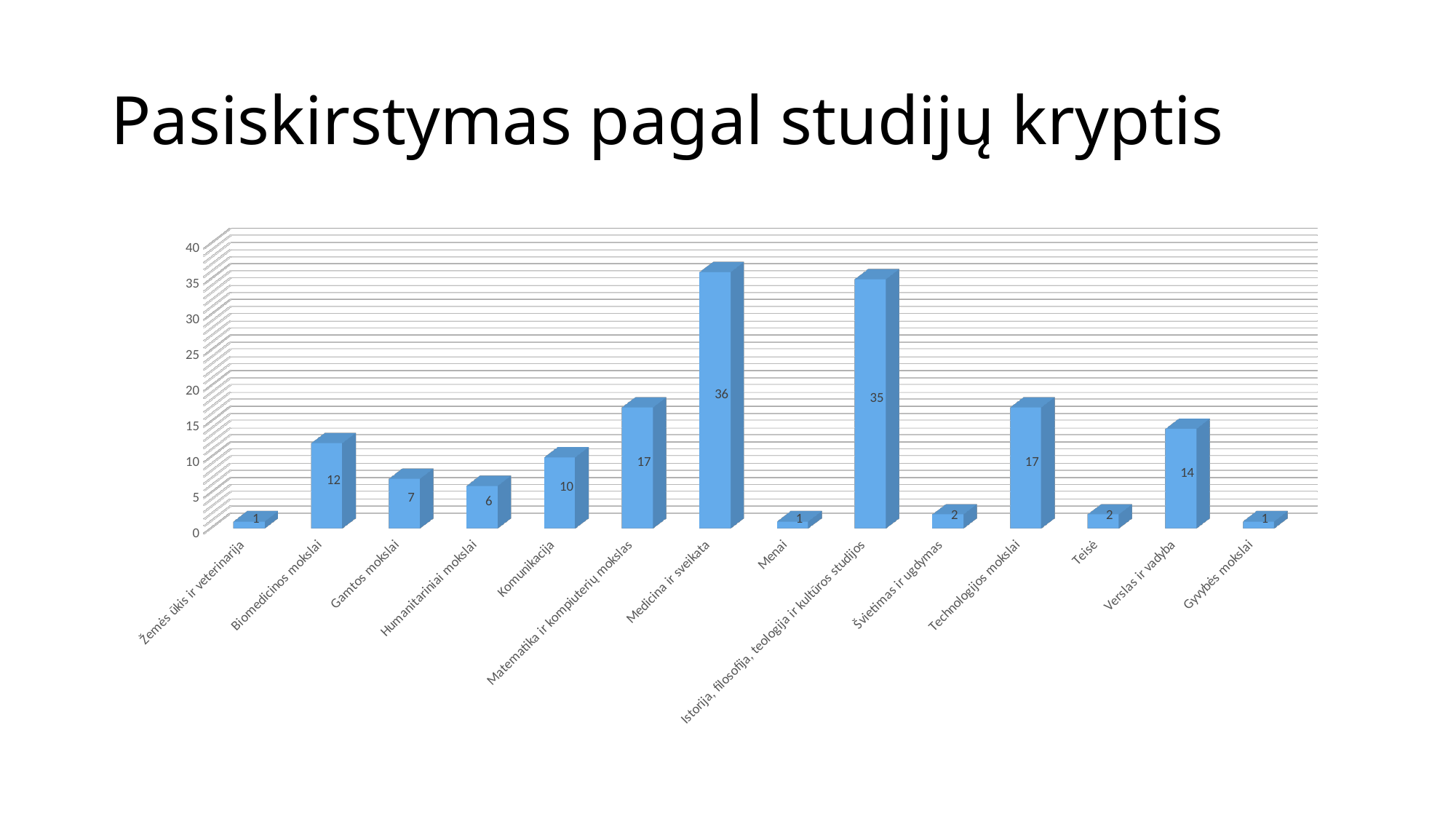
What is the difference between the values for Medicina ir sveikata and Istorija, filosofija, teologija ir kultūros studijos? 1 What is the value for Biomedicinos mokslai? 12 What kind of chart is shown on the slide? Bar chart What is the title of the slide? Pasiskirstymas pagal studijų kryptis How many categories are shown on the x axis? 14 What is the value for Medicina ir sveikata? 36 Which category has the highest value? Medicina ir sveikata What is the value for Verslas ir vadyba? 14 Is the value for Technologijos mokslai greater or less than 15? greater What is the difference between the values for Matematika ir kompiuterių mokslas and Komunikacija? 7 What is the value for Istorija, filosofija, teologija ir kultūros studijos? 35 Which is larger, the value for Gamtos mokslai or the value for Humanitariniai mokslai? Gamtos mokslai